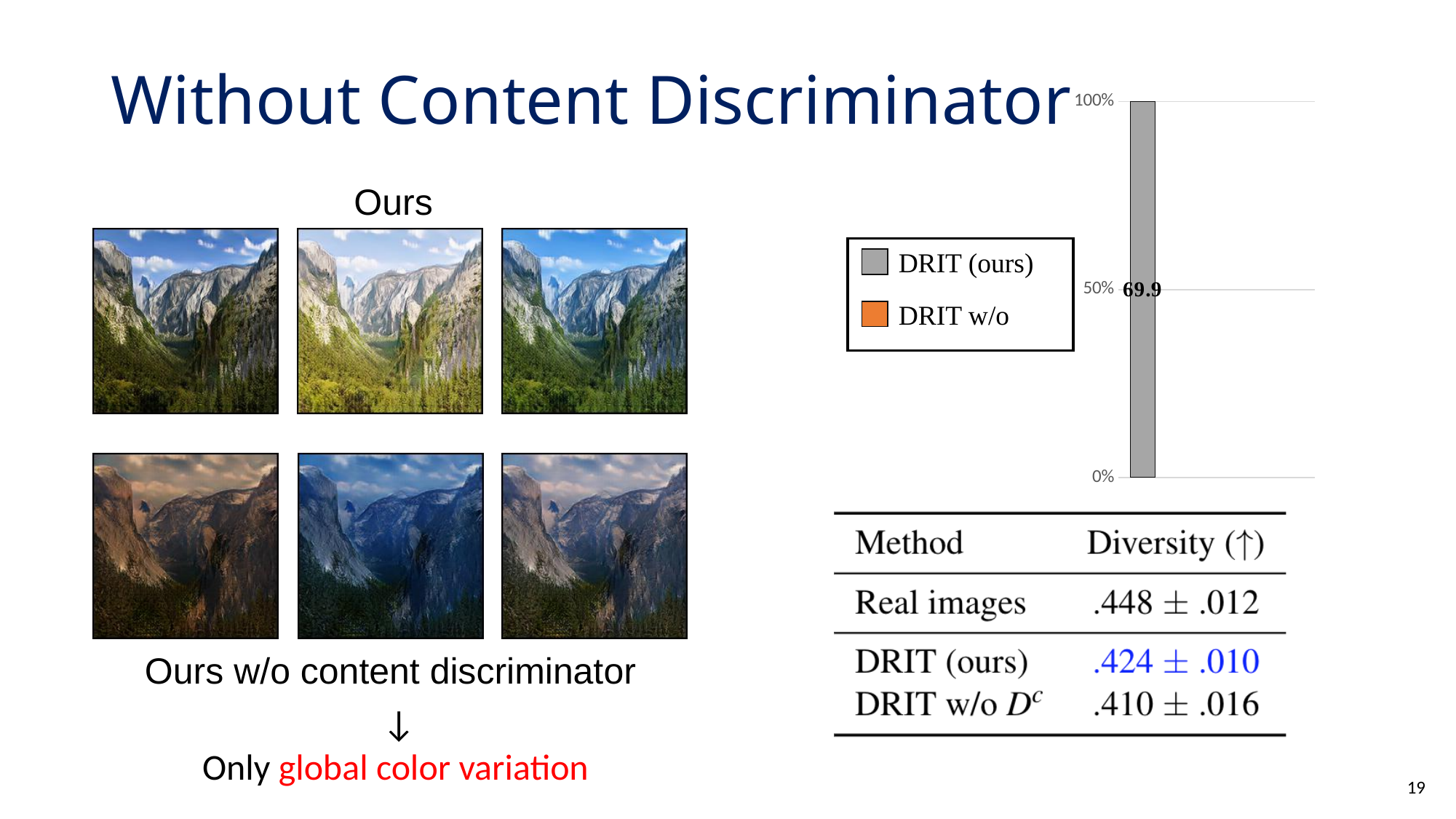
What kind of chart is shown on the right of the slide? bar chart How many series does the chart's legend list? 2 What is the highest tick label on the chart's vertical axis? 100% What are the two legend entries in the chart? DRIT (ours) and DRIT w/o What colour represents DRIT (ours) in the chart legend? gray